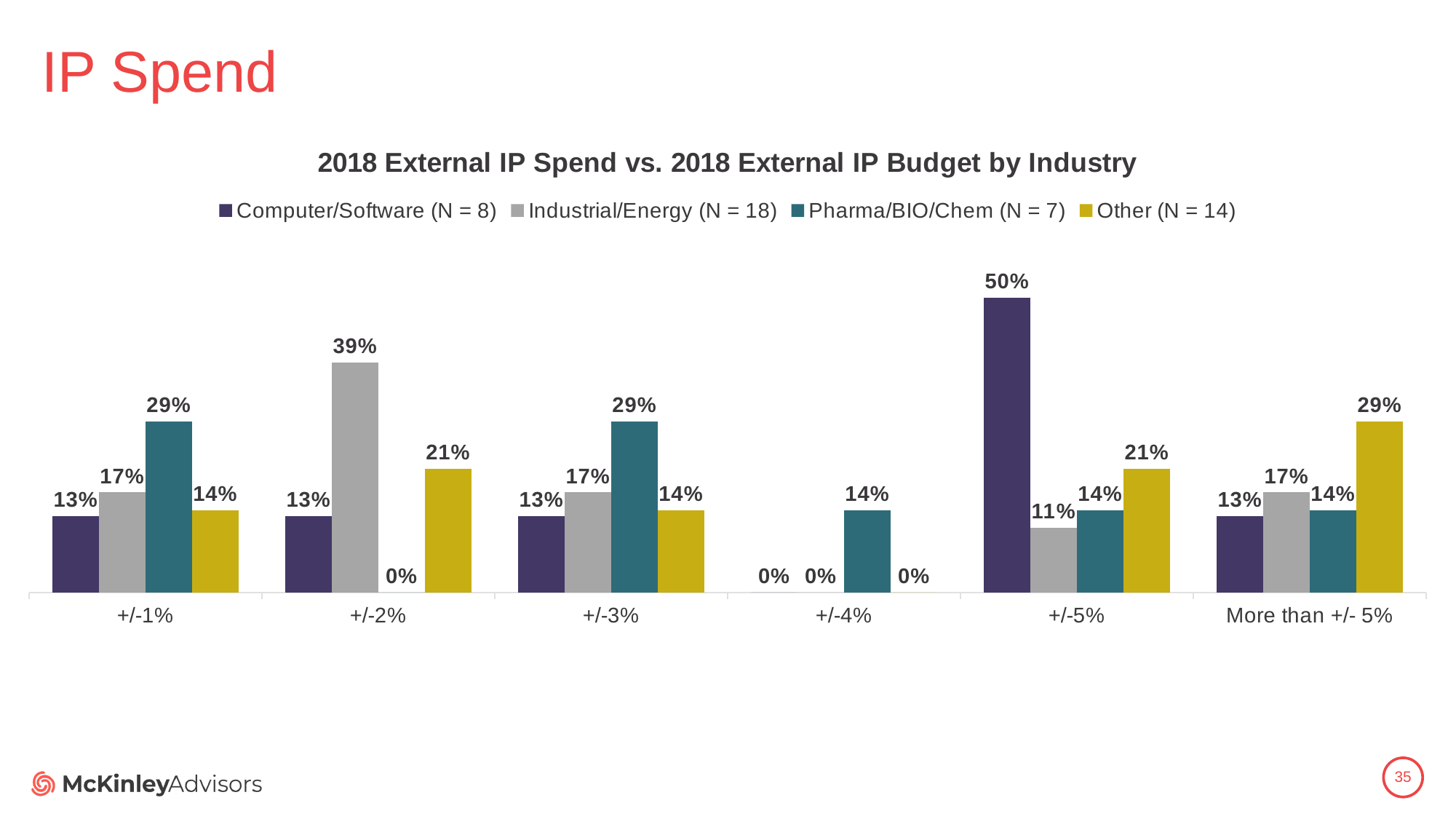
What is the difference between the Industrial/Energy value and the Computer/Software value in the +/-2% category? 26% What is the value for Computer/Software in the +/-5% category? 50% What is the title of the chart? 2018 External IP Spend vs. 2018 External IP Budget by Industry What is the value for Other in the More than +/- 5% category? 29% Which category has the highest value for Computer/Software? +/-5% In the +/-5% category, which is larger: Computer/Software or Other? Computer/Software How many series does the legend list? 4 What kind of chart is shown on the slide? Bar chart How many categories are shown on the x axis? 6 What is the value for Pharma/BIO/Chem in the +/-4% category? 14% What is the value for Industrial/Energy in the +/-2% category? 39% Which category has the lowest value for Industrial/Energy? +/-4%